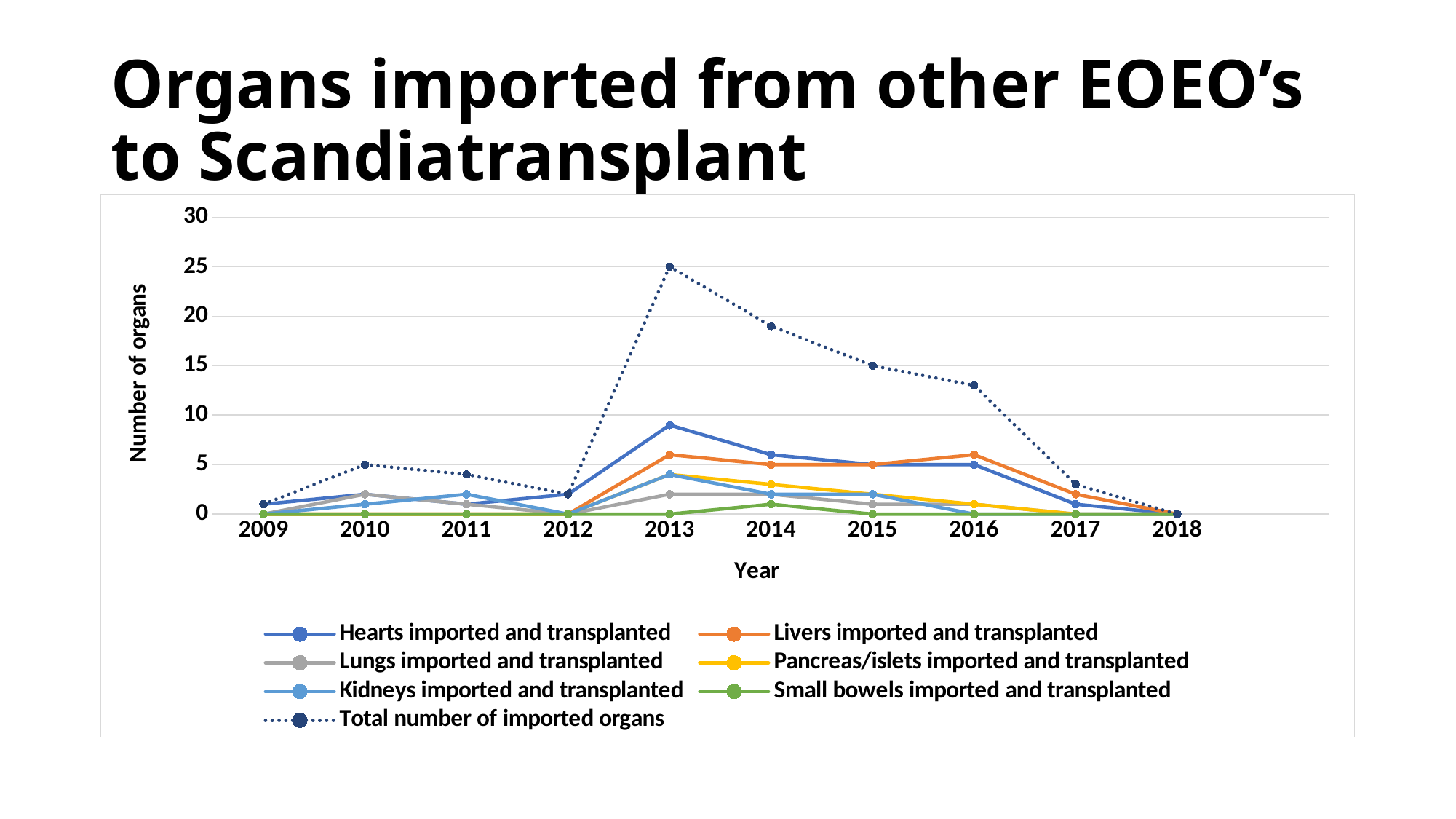
How many years are plotted along the x axis? 10 How many series does the legend list? 7 What kind of chart is shown on the slide? Line chart Is the number of hearts imported and transplanted in 2013 greater or less than 10? less In which year is the total number of imported organs highest? 2013 What is the total number of imported organs in 2010? 5 What is the total number of imported organs in 2015? 15 In which year is the total number of imported organs lowest? 2018 Which is larger in 2013: hearts imported and transplanted or livers imported and transplanted? Hearts imported and transplanted Does the total number of imported organs rise or fall from 2013 to 2018? Fall Is the total number of imported organs in 2014 greater or less than 15? greater What is the total number of imported organs in 2013? 25